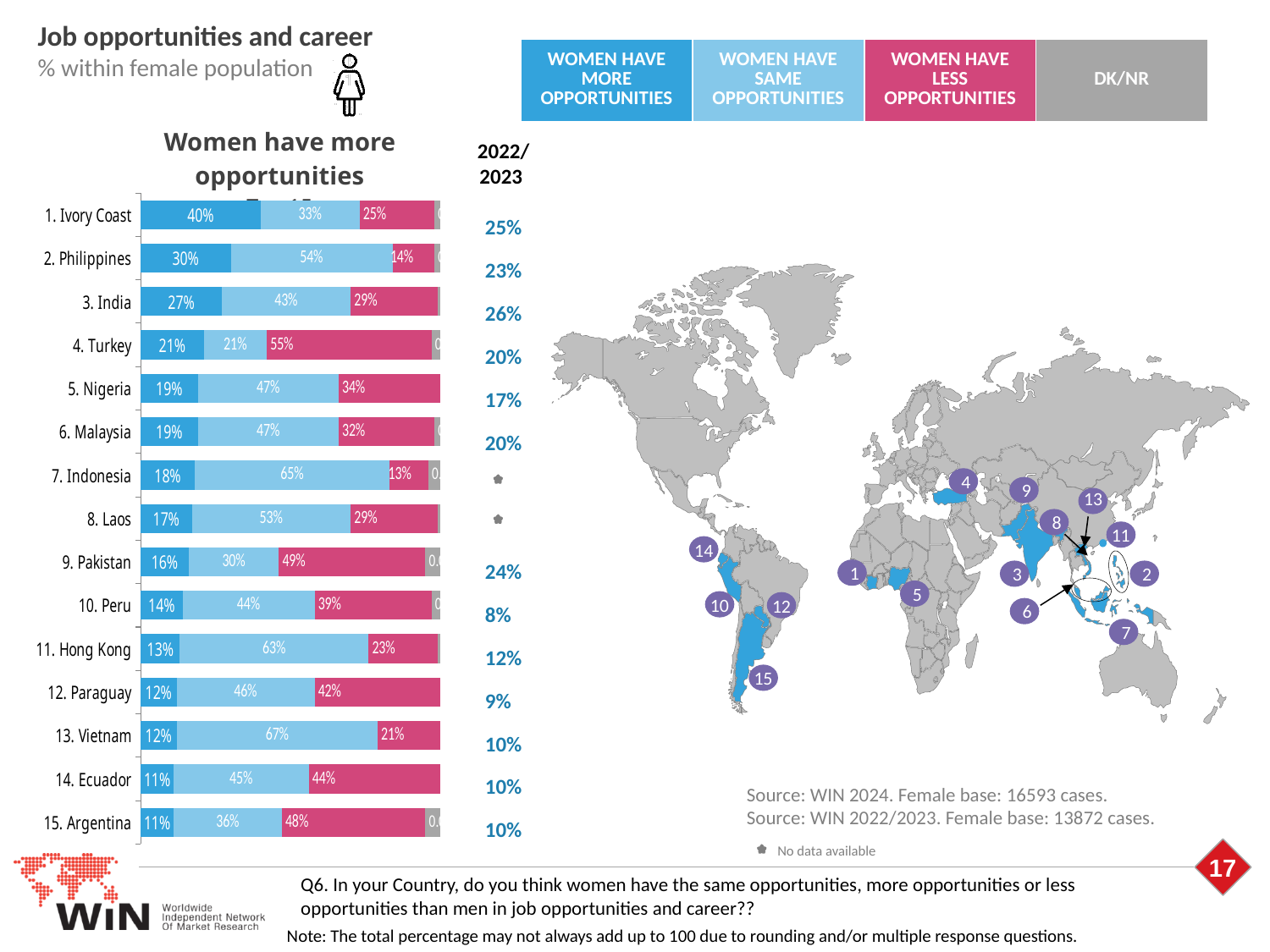
What is the difference in percentage points between Ivory Coast and the Philippines for 'women have more opportunities'? 10 Which is larger: the 'same opportunities' share for India or for Laos? Laos What type of chart is used to show the country results? Stacked bar chart What percentage of women in Turkey say women have less opportunities? 55% What percentage of women in the Philippines say women have the same opportunities? 54% Which country has the lowest share of women saying women have less opportunities? Indonesia How many countries are listed in the bar chart? 15 Which country has the highest share of women saying women have less opportunities? Turkey How many response categories does the legend list? 4 What percentage of women in Ivory Coast say women have more opportunities? 40% Which country has the highest share of women saying women have more opportunities? Ivory Coast What is the 2022/2023 value shown for Pakistan? 24%